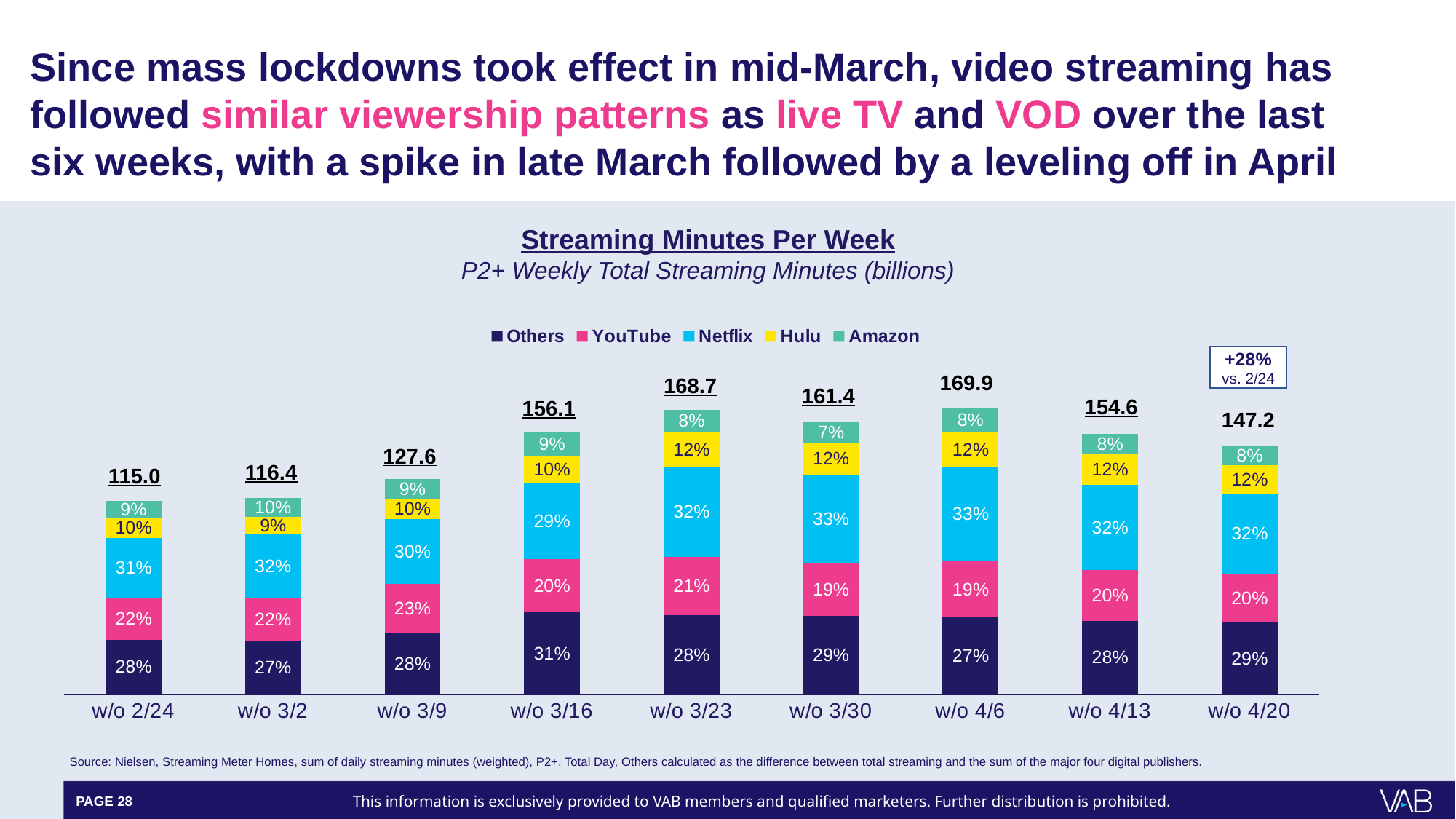
What percentage change versus 2/24 is annotated above the w/o 4/20 bar? +28% What kind of chart is shown on the slide? Stacked bar chart What share of streaming minutes did Netflix account for in w/o 3/30? 33% How many series does the legend list? 5 What is the total streaming minutes (billions) for w/o 3/23? 168.7 What is the difference between the total for w/o 4/6 and the total for w/o 2/24? 54.9 How many weeks (categories) are plotted on the x axis? 9 Do the weekly totals rise or fall from w/o 2/24 to w/o 3/23? Rise Which week has the larger total: w/o 3/16 or w/o 4/13? w/o 3/16 What share of streaming minutes did YouTube account for in w/o 3/9? 23% Which week has the lowest total streaming minutes? w/o 2/24 Which week has the highest total streaming minutes? w/o 4/6